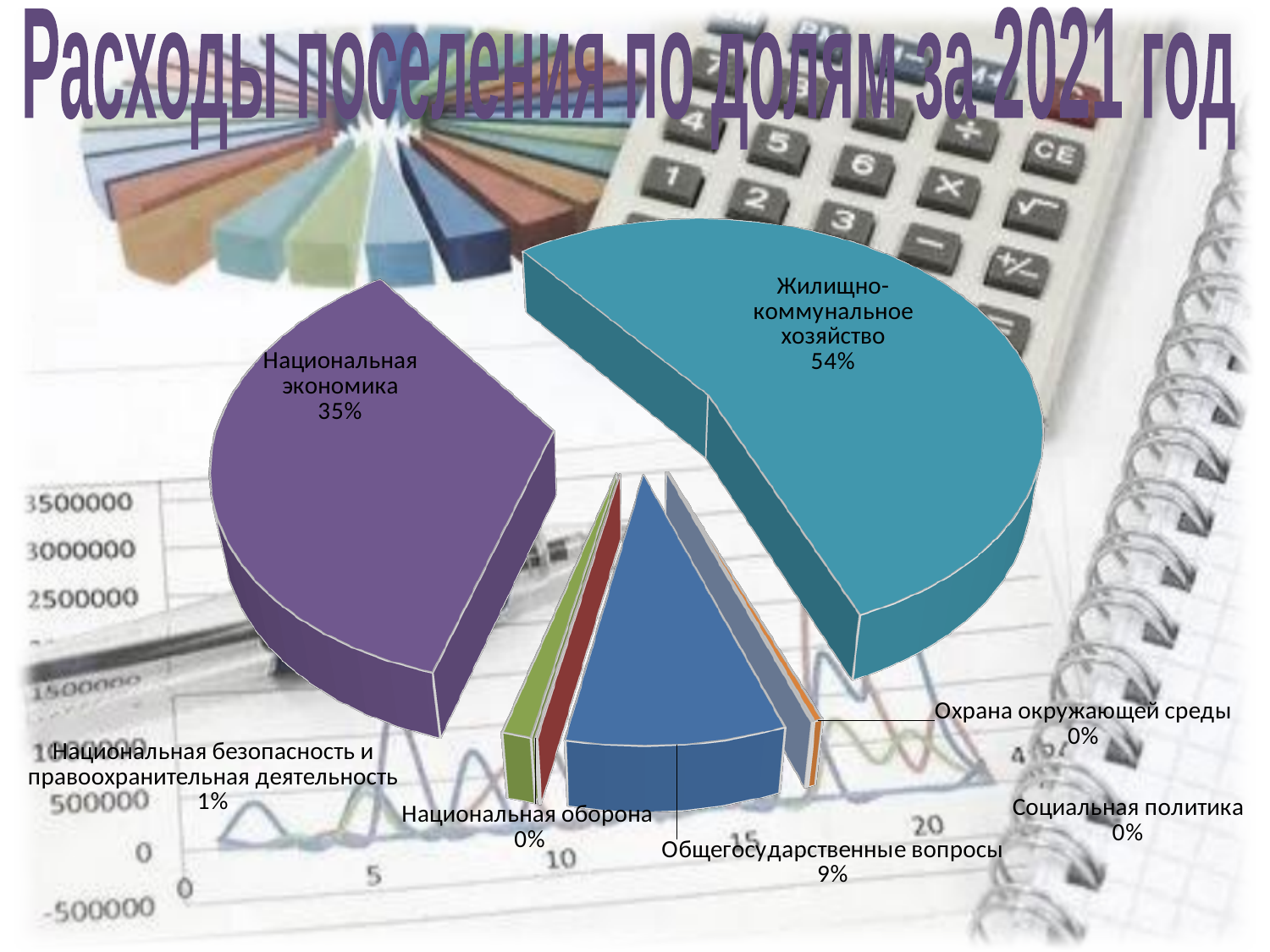
Which is larger: Национальная экономика or Общегосударственные вопросы? Национальная экономика What is the value shown for Национальная безопасность и правоохранительная деятельность? 1% What kind of chart is shown on the slide? Pie chart What is the value shown for Социальная политика? 0% What is the value shown for Национальная экономика? 35% What is the value shown for Общегосударственные вопросы? 9% How many categories are shown in the pie chart? 7 What is the difference in percentage points between Жилищно-коммунальное хозяйство and Национальная экономика? 19 What is the title of the chart on the slide? Расходы поселения по долям за 2021 год What share of expenses does Жилищно-коммунальное хозяйство account for? 54% Which category has the largest share of the pie? Жилищно-коммунальное хозяйство What is the value shown for Охрана окружающей среды? 0%